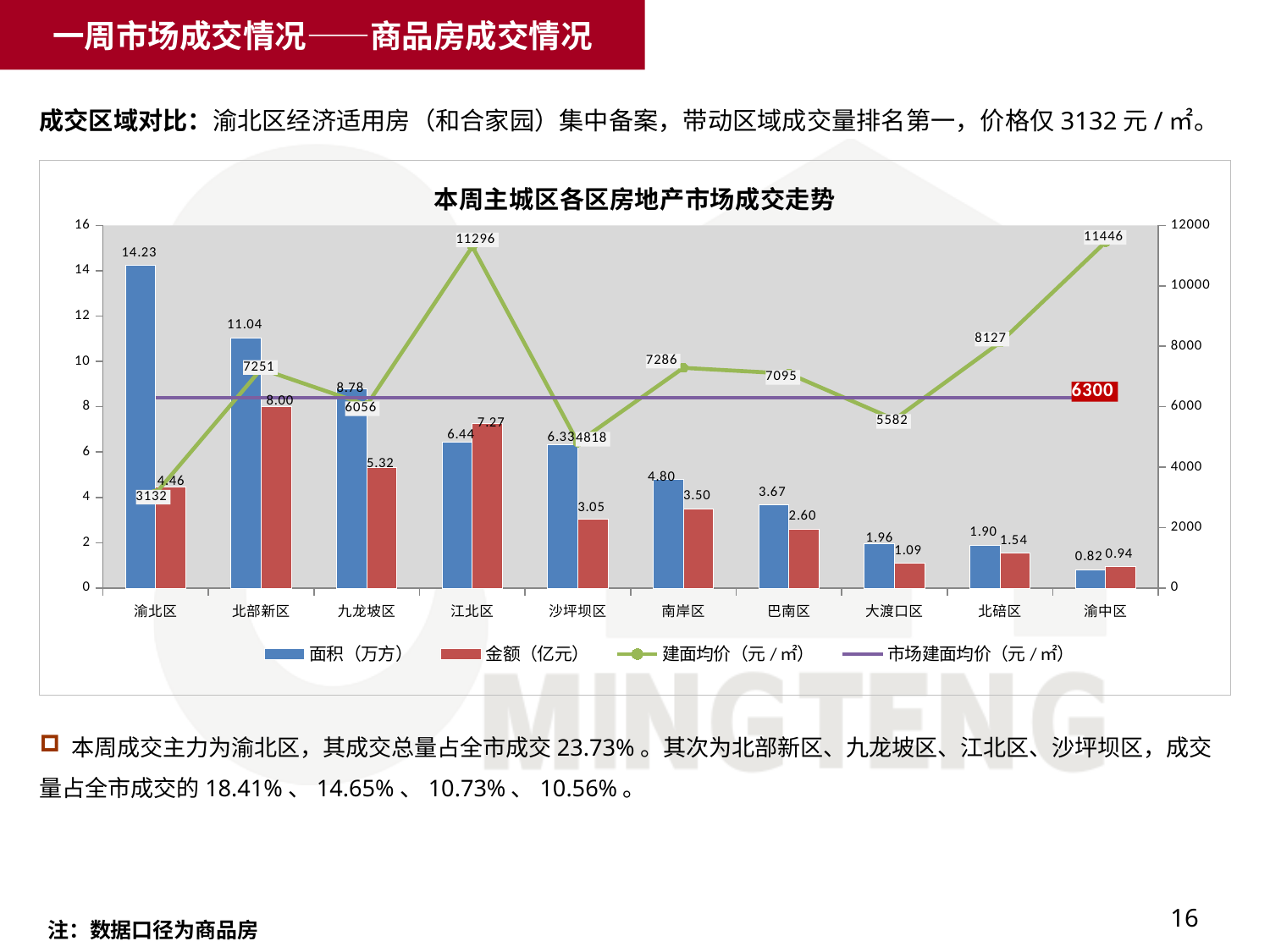
What value does the 市场建面均价（元/㎡） line show? 6300 Which district has the lowest 面积（万方）? 渝中区 What is the title of the chart? 本周主城区各区房地产市场成交走势 How many series does the legend list? 4 Which district has the highest 建面均价（元/㎡）? 渝中区 Which is larger for 北部新区: 面积（万方） or 金额（亿元）? 面积（万方） What is the difference between the 面积（万方） values of 渝北区 and 北部新区? 3.19 What is the 面积（万方） value for 渝北区? 14.23 What is the 建面均价（元/㎡） value for 北碚区? 8127 What is the 金额（亿元） value for 江北区? 7.27 Is the 建面均价（元/㎡） for 沙坪坝区 greater or less than 6000? less How many districts are shown on the x axis? 10